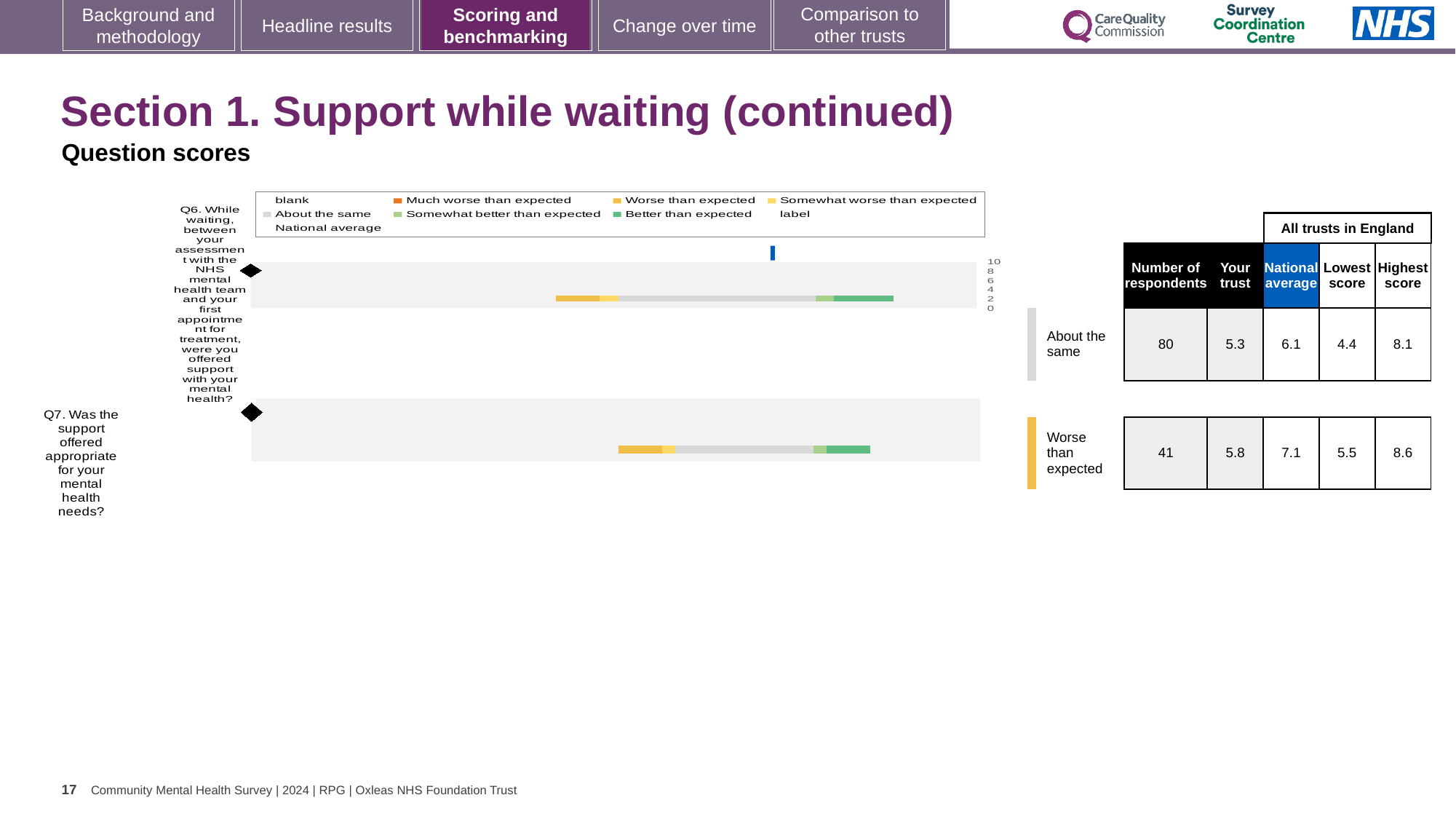
For Q6, what is the difference between the highest score and the lowest score among all trusts in England? 3.7 Which benchmark category is Q7 placed in? Worse than expected How many questions are plotted on the chart? 2 For Q6, which is larger: the 'Your trust' score or the national average? National average What is the national average score for Q7 (Was the support offered appropriate for your mental health needs?)? 7.1 What is the 'Your trust' score for Q6? 5.3 What is the highest score among all trusts in England for Q7? 8.6 How many respondents are shown for Q6 (While waiting, between your assessment with the NHS mental health team and your first appointment for treatment, were you offered support with your mental health?)? 80 For Q7, what is the difference between the national average and the 'Your trust' score? 1.3 What kind of chart is used to show the question scores? Bar chart Which question has the higher number of respondents, Q6 or Q7? Q6 Which benchmark category is Q6 placed in? About the same